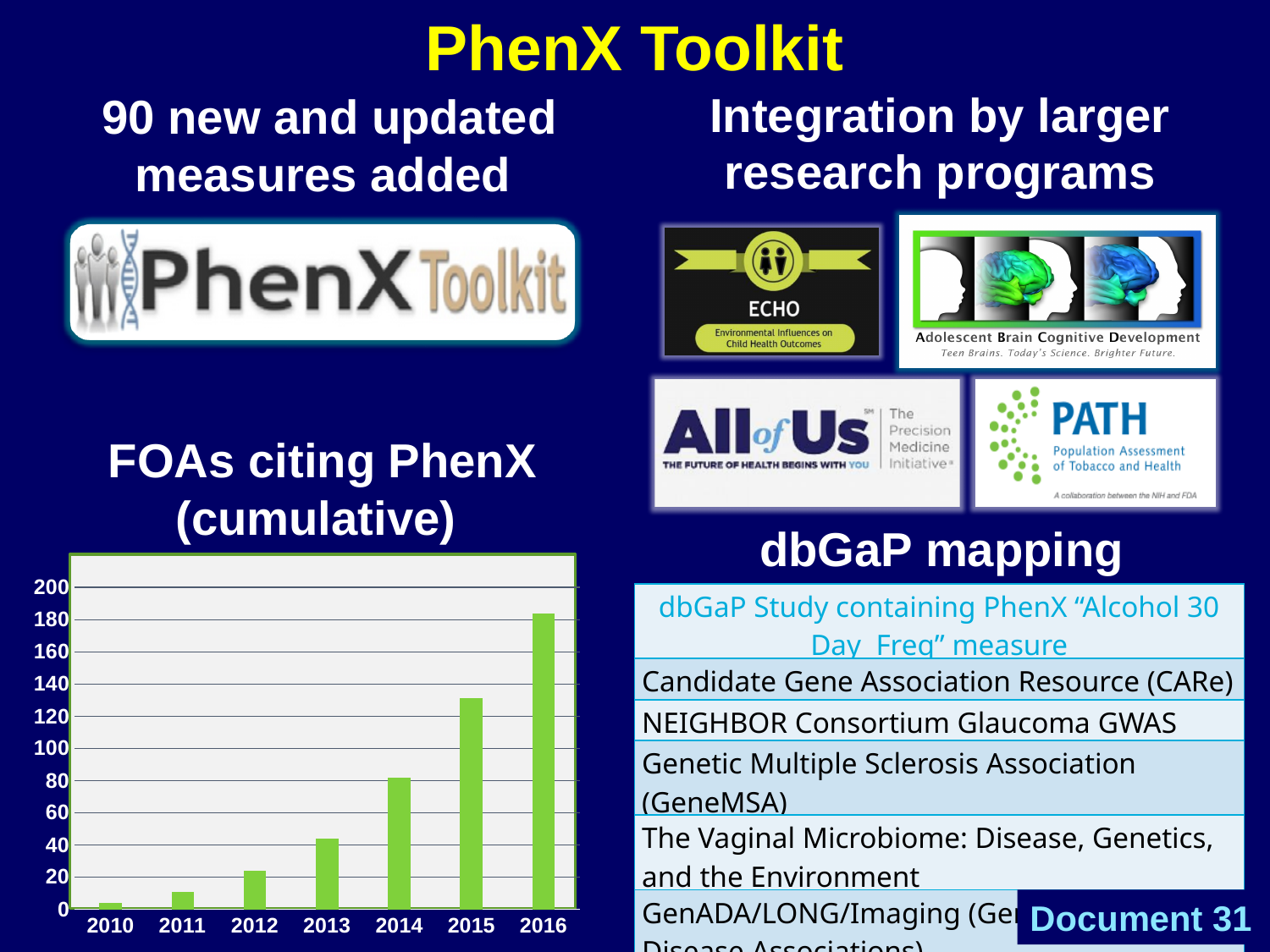
In the "FOAs citing PhenX (cumulative)" chart, do the values rise or fall from 2010 to 2016? rise In the "FOAs citing PhenX (cumulative)" chart, is the value for 2013 greater or less than 60? less In the "FOAs citing PhenX (cumulative)" chart, which year has the larger value, 2014 or 2015? 2015 In the "FOAs citing PhenX (cumulative)" chart, which year has the highest bar? 2016 In the "FOAs citing PhenX (cumulative)" chart, is the value for 2011 greater or less than 20? less What kind of chart is shown under the heading "FOAs citing PhenX (cumulative)"? bar chart In the "FOAs citing PhenX (cumulative)" chart, is the value for 2015 greater or less than 120? greater How many years are shown on the x axis of the "FOAs citing PhenX (cumulative)" chart? 7 In the "FOAs citing PhenX (cumulative)" chart, which year has the lowest bar? 2010 What colour are the bars in the "FOAs citing PhenX (cumulative)" chart? green